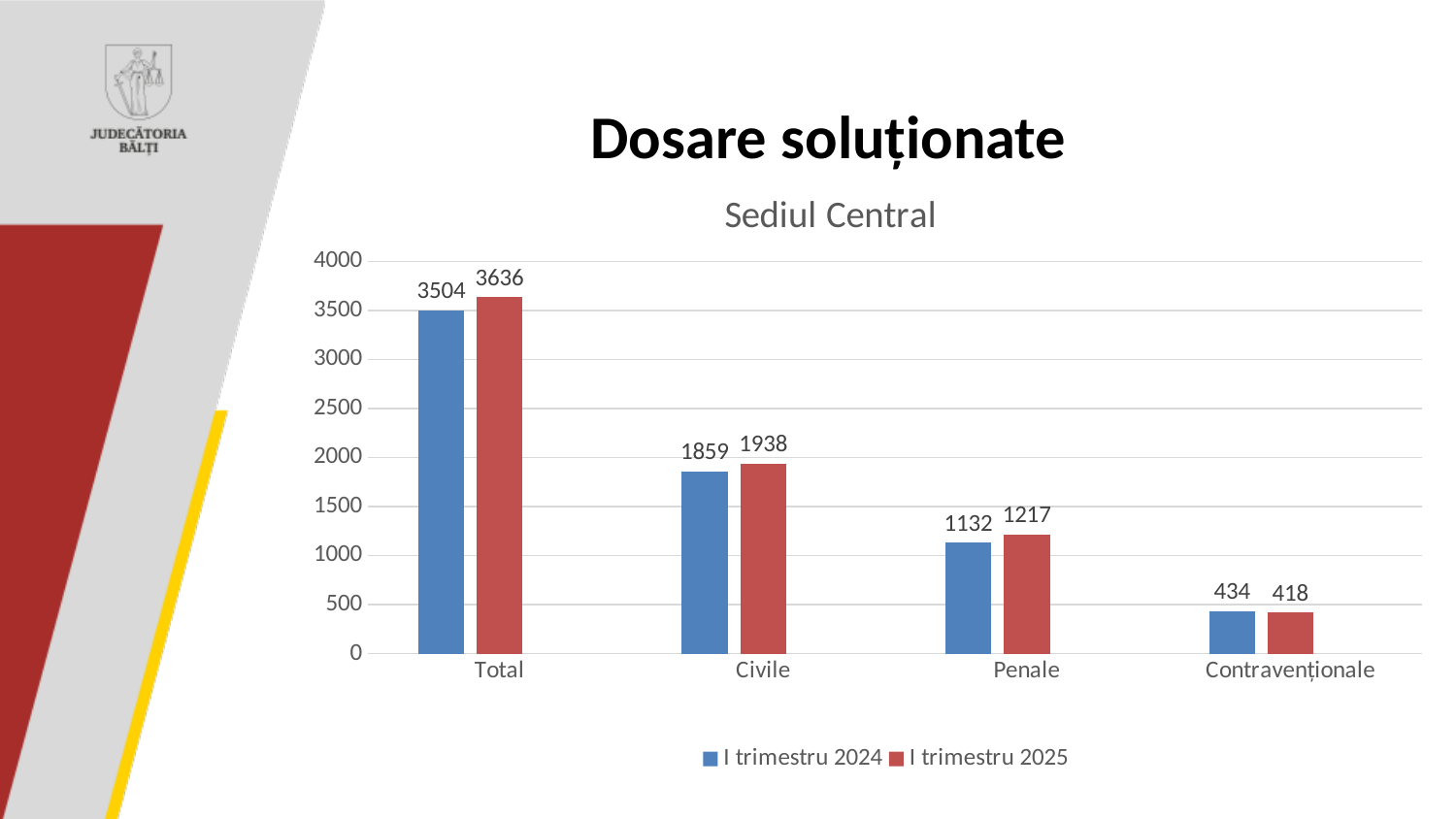
Which category has the lowest value in I trimestru 2025? Contravenționale What is the value for Contravenționale in I trimestru 2024? 434 What is the difference between the I trimestru 2025 and I trimestru 2024 values for Civile? 79 What is the value for Penale in I trimestru 2025? 1217 What is the value for Total in I trimestru 2025? 3636 What is the value for Civile in I trimestru 2024? 1859 Which category has the highest value in I trimestru 2024? Total What kind of chart is shown on the slide? Bar chart What is the difference between the I trimestru 2025 and I trimestru 2024 values for Total? 132 How many categories are shown on the x axis? 4 How many series does the legend list? 2 Which is larger for Contravenționale: I trimestru 2024 or I trimestru 2025? I trimestru 2024